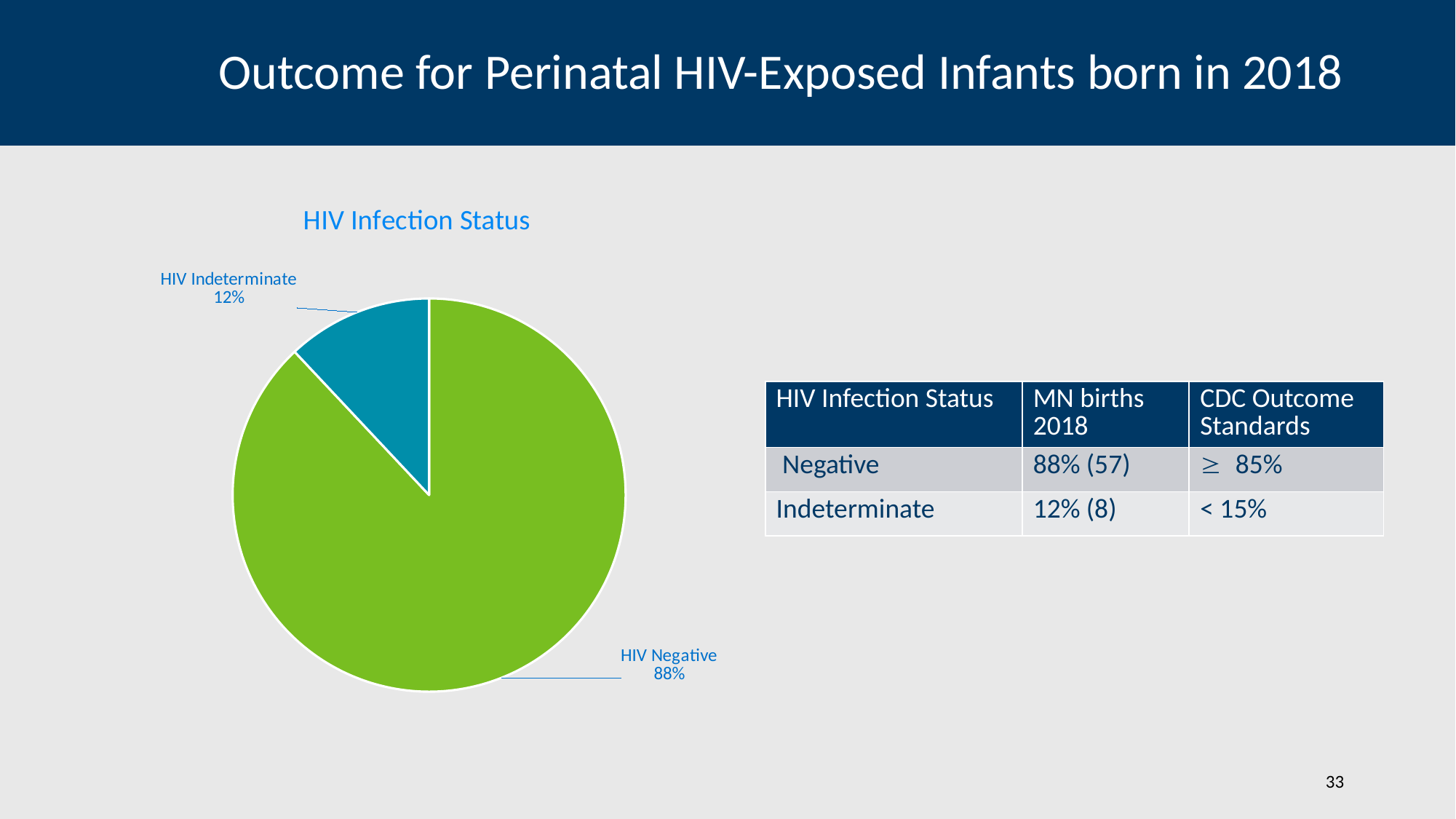
What colour is the HIV Negative slice? green What kind of chart is shown on the slide? pie chart What share of the pie is HIV Indeterminate? 12% What share of the pie is HIV Negative? 88% Which slice of the pie is the smallest? HIV Indeterminate How many slices does the pie chart have? 2 What is the title of the chart? HIV Infection Status Which is larger, the HIV Negative slice or the HIV Indeterminate slice? HIV Negative What is the difference in percentage points between the HIV Negative and HIV Indeterminate slices? 76 Which slice of the pie is the largest? HIV Negative